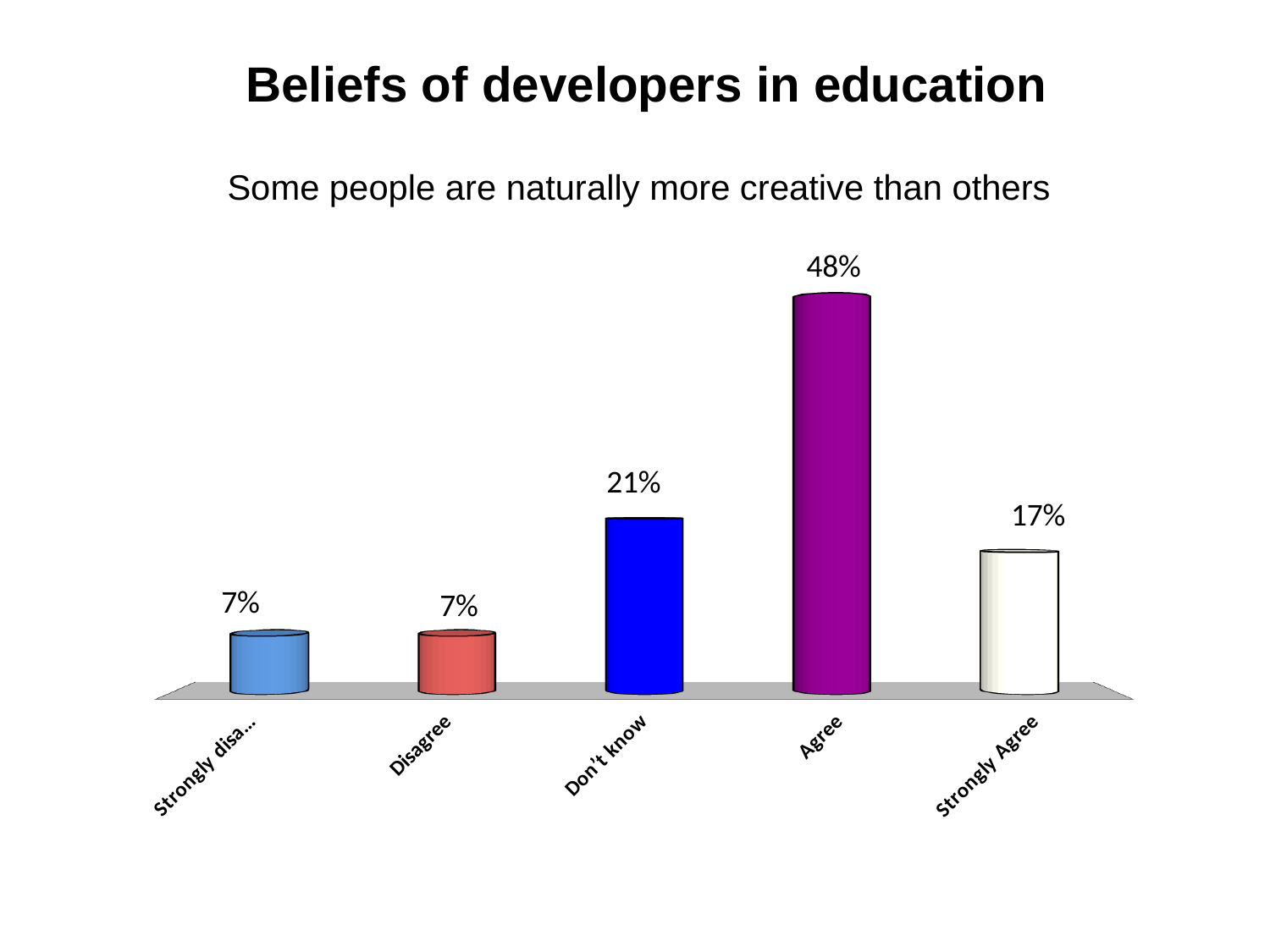
Which is larger, the value for Don't know or the value for Strongly Agree? Don't know What is the title of the chart? Some people are naturally more creative than others What is the value for Agree? 48% What is the value for Don't know? 21% What is the difference between the values for Don't know and Disagree? 14% What kind of chart is shown on the slide? Bar chart What is the lowest value shown on the chart? 7% How many categories are shown on the chart? 5 What is the value for Disagree? 7% Which category has the highest value? Agree What is the value for Strongly Agree? 17% What is the difference between the values for Agree and Strongly Agree? 31%